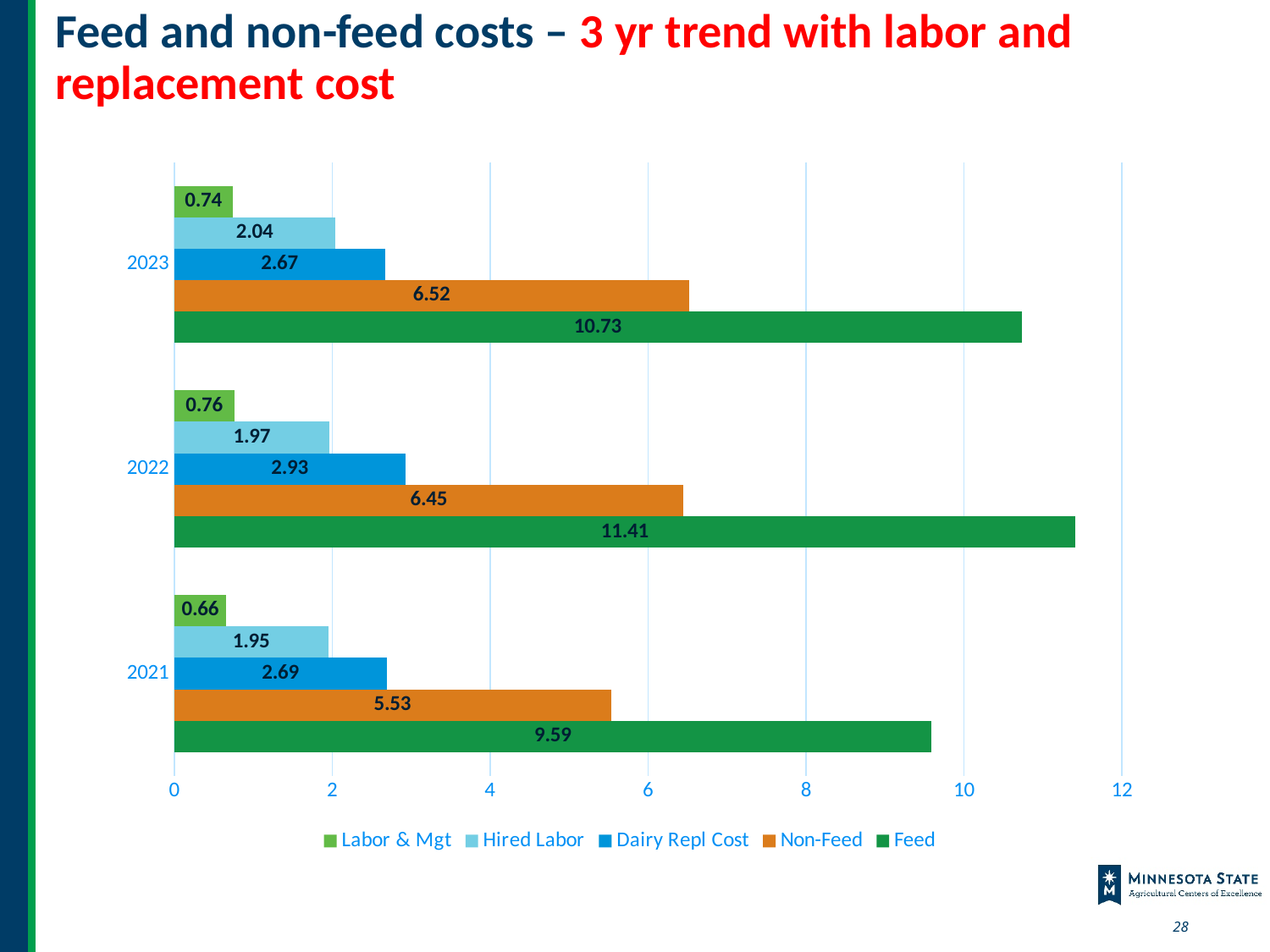
Which is larger, the Non-Feed value for 2023 or for 2022? 2023 What is the Dairy Repl Cost value for 2022? 2.93 What is the difference between the Feed values for 2022 and 2021? 1.82 How many years are shown on the chart? 3 What kind of chart is shown on the slide? Bar chart What is the Non-Feed value for 2021? 5.53 What is the Hired Labor value for 2023? 2.04 What is the Feed value for 2023? 10.73 Which year has the lowest Labor & Mgt value? 2021 How many series does the legend list? 5 Which year has the highest Feed value? 2022 Which series is shown in orange in the legend? Non-Feed